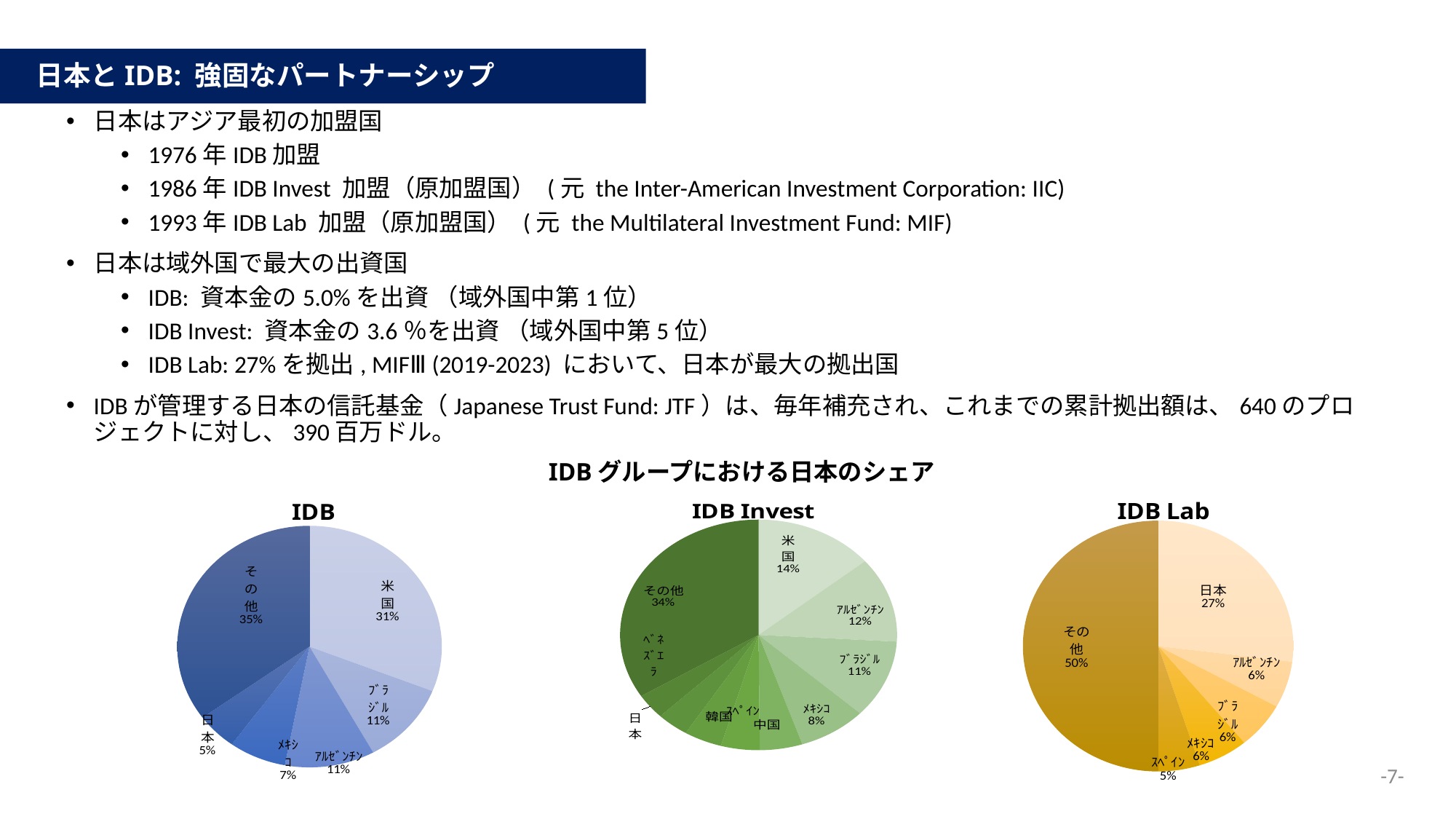
In the IDB pie chart, what share does 米国 hold? 31% In the IDB Lab pie chart, what share does その他 hold? 50% In the IDB pie chart, what share does 日本 hold? 5% In the IDB Invest pie chart, what share does メキシコ hold? 8% What kind of chart is used for the IDB, IDB Invest and IDB Lab charts? Pie chart In the IDB Lab pie chart, what share does 日本 hold? 27% In the IDB pie chart, which labelled slice is the largest? その他 In the IDB Lab pie chart, which labelled slice is the smallest? スペイン In the IDB Invest pie chart, what share does 米国 hold? 14% In the IDB Invest pie chart, which is larger, the share of アルゼンチン or the share of メキシコ? アルゼンチン What is the common title above the three pie charts? IDBグループにおける日本のシェア In the IDB pie chart, what is the difference between the shares of 米国 and 日本? 26%